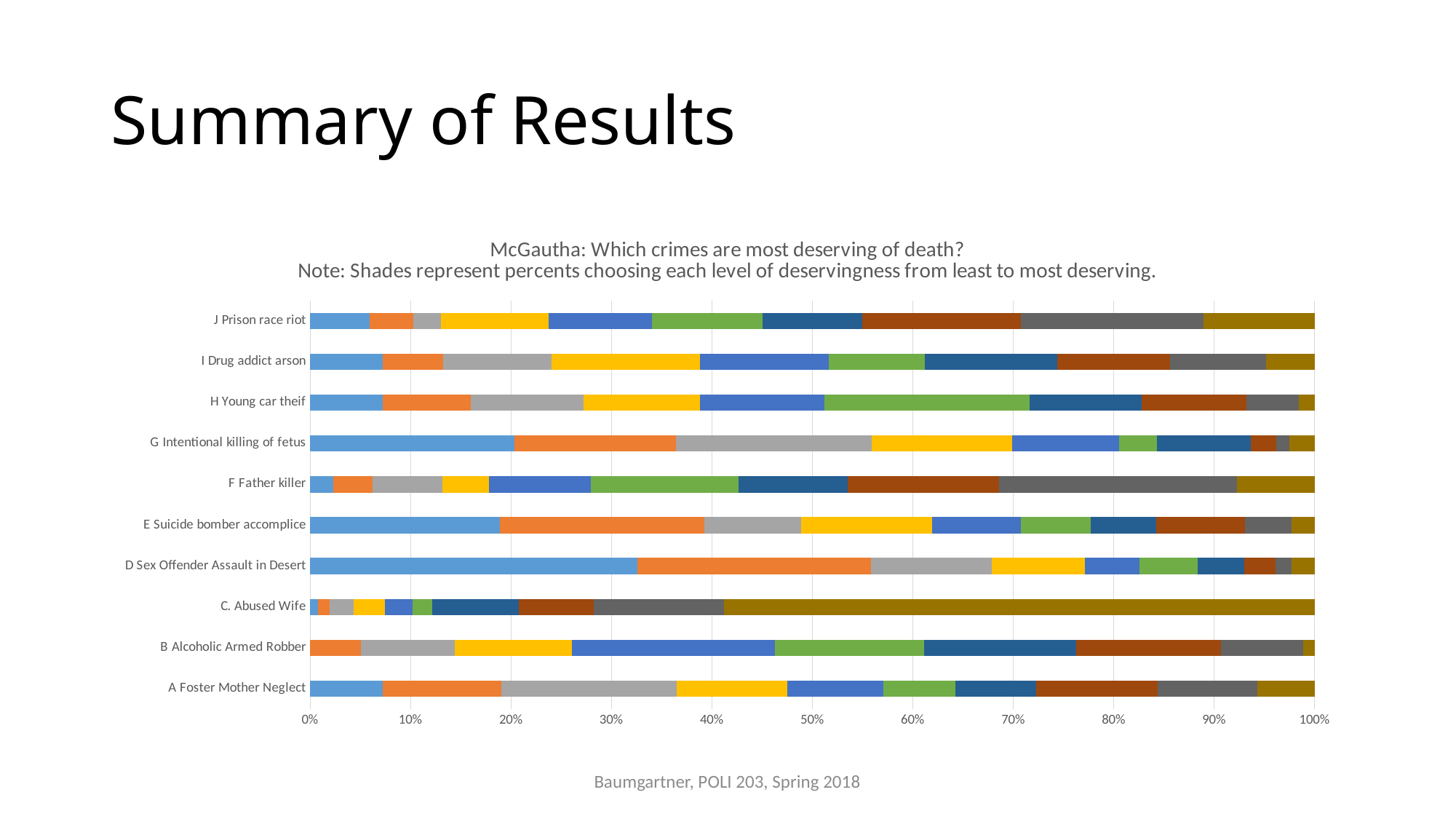
How many crime categories are listed on the vertical axis of the chart? 10 What is the highest value shown on the horizontal axis of the chart? 100% Which category has the largest last (dark gold, most deserving) segment? C. Abused Wife Is the first (light blue) segment for E Suicide bomber accomplice greater or less than 10%? greater Which has the larger last (dark gold) segment: C. Abused Wife or J Prison race riot? C. Abused Wife What kind of chart is shown on the slide? Stacked bar chart Which category has the largest first (light blue, least deserving) segment? D Sex Offender Assault in Desert Is the first (light blue) segment for D Sex Offender Assault in Desert greater or less than 30%? greater Is the first (light blue) segment for F Father killer greater or less than 10%? less Which has the larger first (light blue) segment: D Sex Offender Assault in Desert or G Intentional killing of fetus? D Sex Offender Assault in Desert What is the first line of the chart's title? McGautha: Which crimes are most deserving of death?